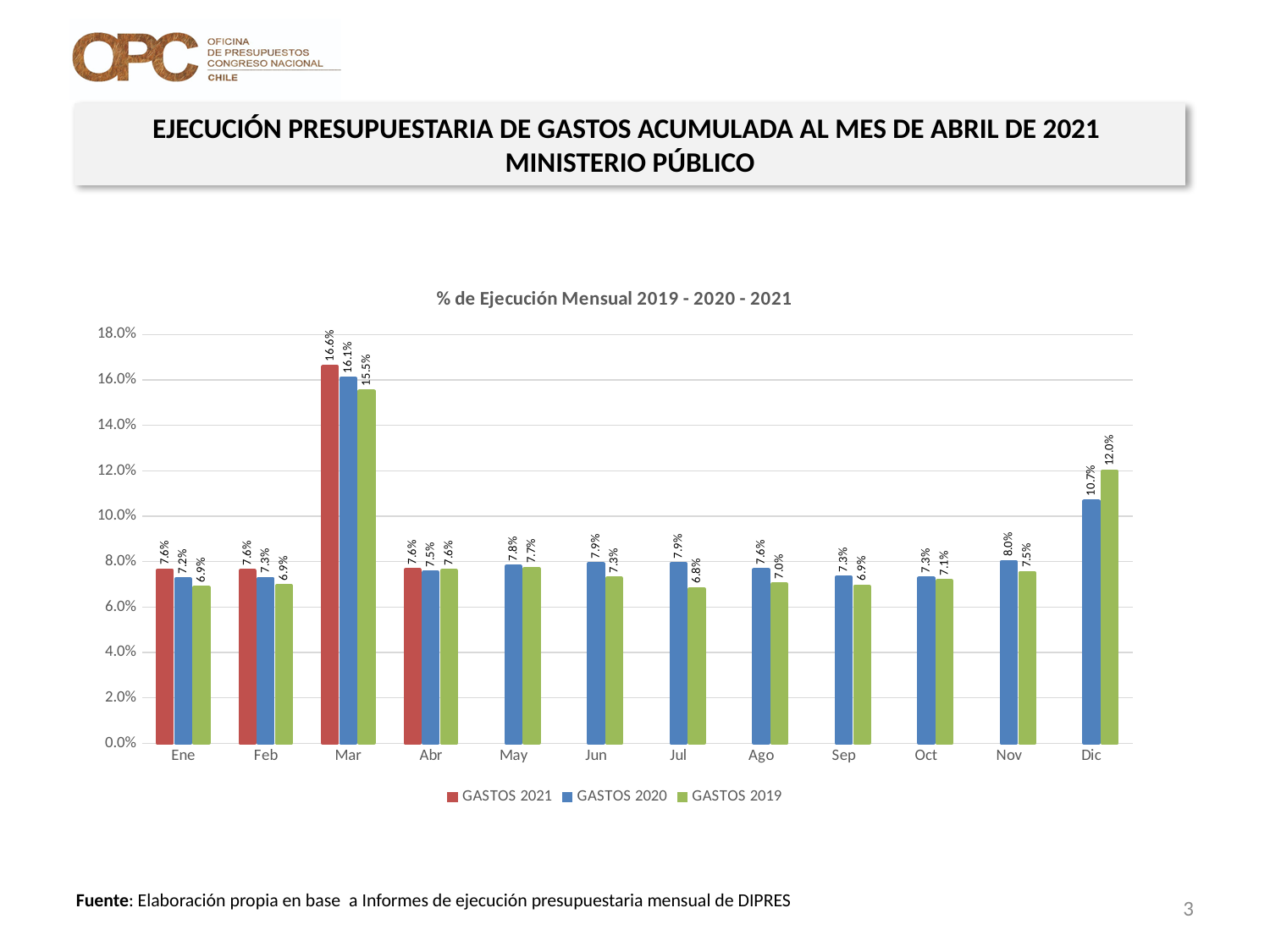
Which month has the highest value for GASTOS 2020? Mar What is the value for GASTOS 2020 in Nov? 8.0% What is the value for GASTOS 2019 in Dic? 12.0% What is the difference between GASTOS 2021 and GASTOS 2019 in Mar? 1.1% What is the title of the chart? % de Ejecución Mensual 2019 - 2020 - 2021 Is the value for GASTOS 2020 in Mar greater or less than 14.0%? greater What kind of chart is shown on the slide? Bar chart Which month has the lowest value for GASTOS 2019? Jul How many series does the legend list? 3 How many months are shown on the x axis? 12 What is the value for GASTOS 2021 in Mar? 16.6% In Dic, which is larger: GASTOS 2020 or GASTOS 2019? GASTOS 2019